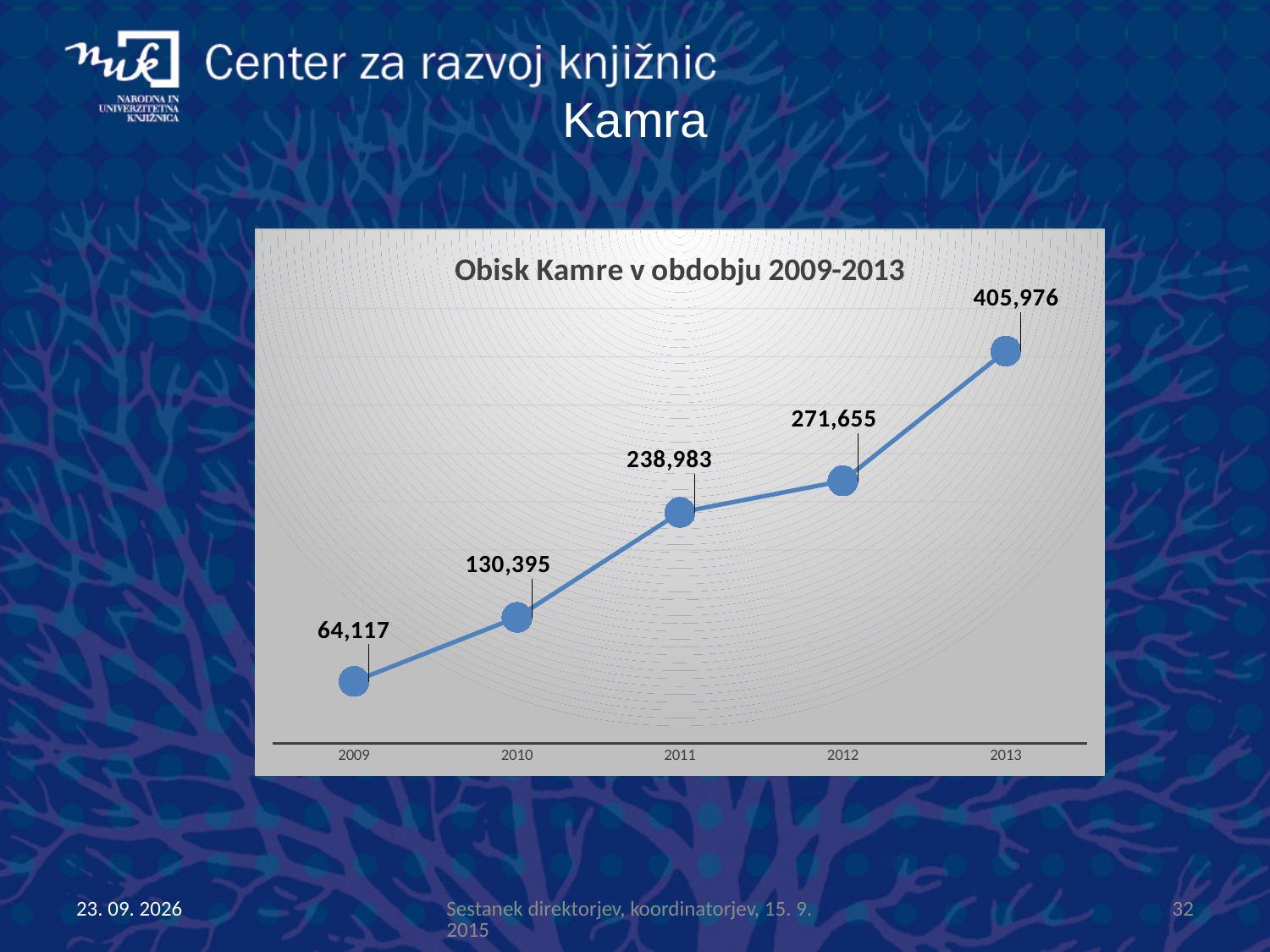
What is the value for 2009? 64,117 What is the value for 2013? 405,976 What is the difference between the values for 2013 and 2012? 134,321 What kind of chart is shown on the slide? Line chart What is the value for 2012? 271,655 Which is larger, the value for 2011 or the value for 2010? 2011 What is the difference between the values for 2010 and 2009? 66,278 What is the value for 2011? 238,983 Which year has the highest value? 2013 Do the values rise or fall from 2009 to 2013? Rise Which year has the lowest value? 2009 How many data points are plotted on the chart? 5